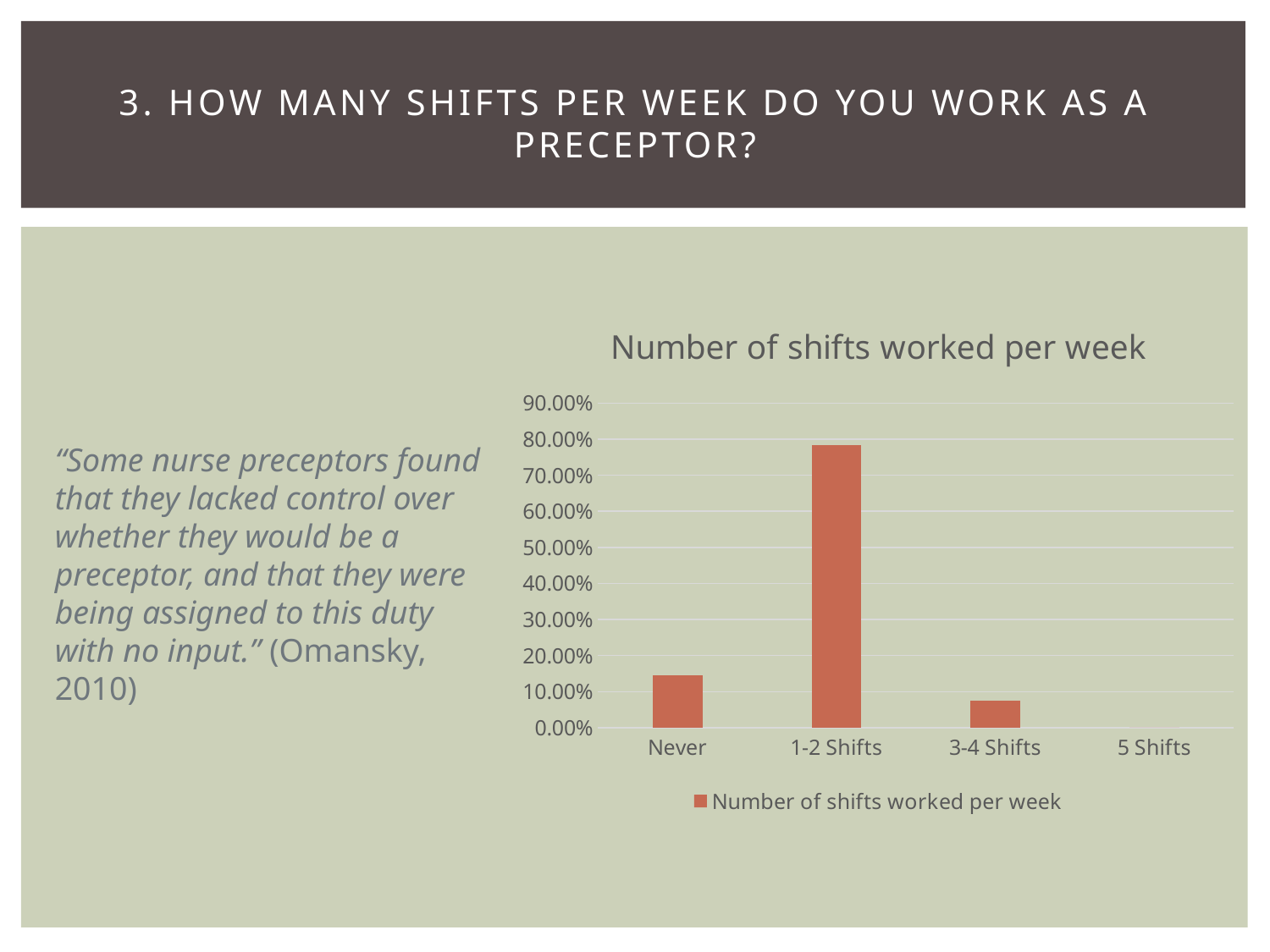
What kind of chart is shown on the slide? bar chart Which category has the lowest value in the chart? 5 Shifts How many series does the chart's legend list? 1 How many categories are shown on the x axis of the chart? 4 Is the value for 1-2 Shifts greater or less than 70.00%? greater What is the title of the chart? Number of shifts worked per week Is the value for Never greater or less than 20.00%? less Is the value for Never greater or less than 10.00%? greater Which is larger, the value for Never or the value for 3-4 Shifts? Never What is the name of the series listed in the chart's legend? Number of shifts worked per week Which category has the highest value in the chart? 1-2 Shifts